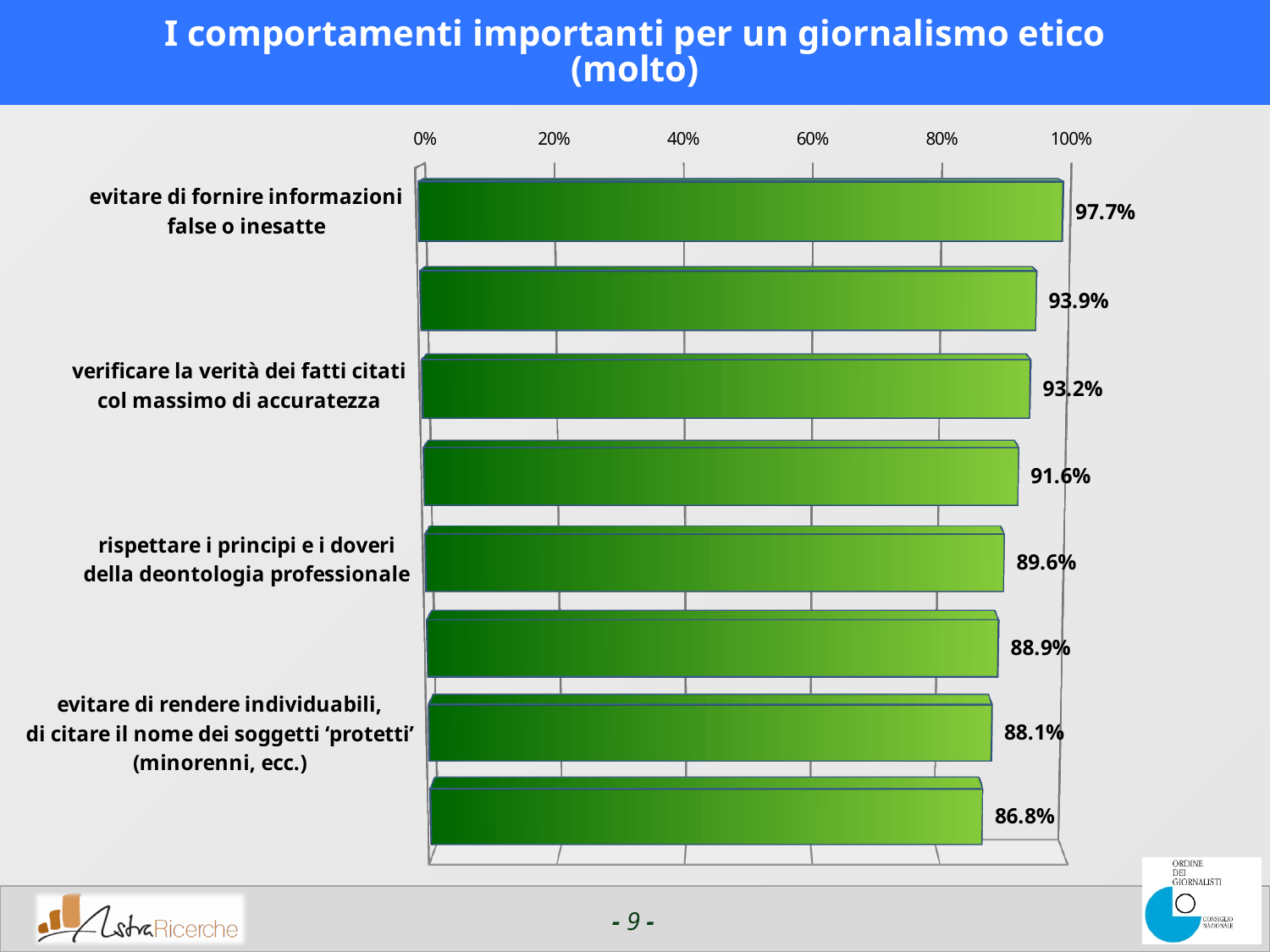
What is the difference between the values for "evitare di fornire informazioni false o inesatte" and "rispettare i principi e i doveri della deontologia professionale"? 8.1% Which behaviour has the highest percentage in the chart? evitare di fornire informazioni false o inesatte What value is shown for "evitare di rendere individuabili, di citare il nome dei soggetti 'protetti' (minorenni, ecc.)"? 88.1% What percentage is shown for "rispettare i principi e i doveri della deontologia professionale"? 89.6% How many bars are plotted in the chart? 8 What kind of chart is shown on the slide? bar chart What is the lowest value shown on any bar in the chart? 86.8% Is the value for "rispettare i principi e i doveri della deontologia professionale" greater or less than 80%? greater What value is shown for "verificare la verità dei fatti citati col massimo di accuratezza"? 93.2% What percentage is shown for "evitare di fornire informazioni false o inesatte"? 97.7% Which is larger: the value for "verificare la verità dei fatti citati col massimo di accuratezza" or for "evitare di rendere individuabili, di citare il nome dei soggetti 'protetti' (minorenni, ecc.)"? verificare la verità dei fatti citati col massimo di accuratezza What is the title of the chart on the slide? I comportamenti importanti per un giornalismo etico (molto)